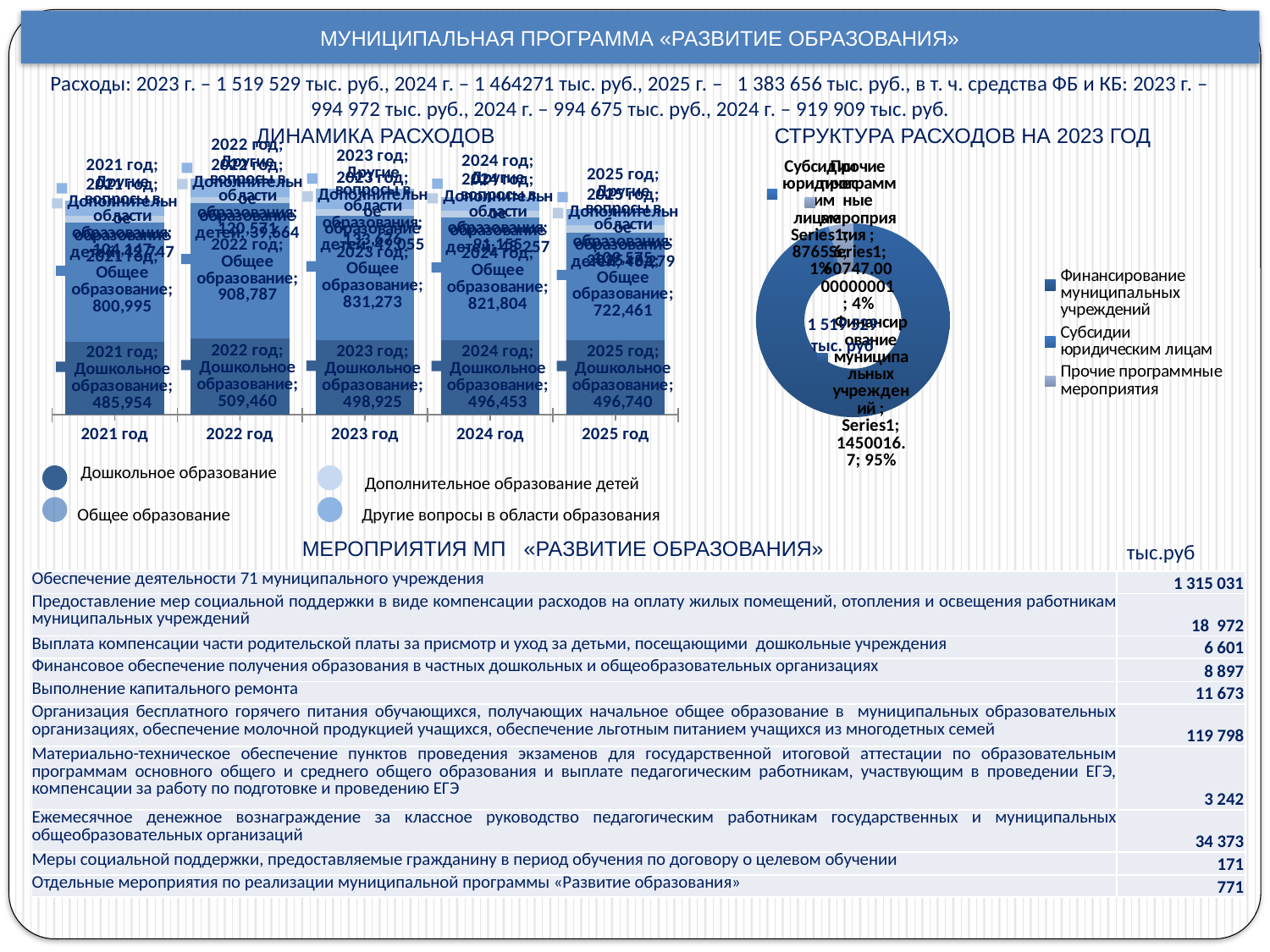
In the ДИНАМИКА РАСХОДОВ chart, what is the value for Общее образование in 2025? 722,461 In the ДИНАМИКА РАСХОДОВ chart, what is the value for Дошкольное образование in 2024? 496,453 In the ДИНАМИКА РАСХОДОВ chart, which year has the highest value for Общее образование? 2022 год In the ДИНАМИКА РАСХОДОВ chart, what is the value for Дошкольное образование in 2022? 509,460 In the СТРУКТУРА РАСХОДОВ НА 2023 ГОД chart, what share does Финансирование муниципальных учреждений have? 95% How many entries does the legend of the СТРУКТУРА РАСХОДОВ НА 2023 ГОД chart list? 3 In the ДИНАМИКА РАСХОДОВ chart, which year has the lowest value for Дошкольное образование? 2021 год In the ДИНАМИКА РАСХОДОВ chart, which is larger: Дошкольное образование in 2023 or in 2025? 2023 (498,925) In the ДИНАМИКА РАСХОДОВ chart, what is the value for Общее образование in 2023? 831,273 In the ДИНАМИКА РАСХОДОВ chart, what is the difference between Общее образование in 2022 and in 2023? 77,514 How many years are shown on the x axis of the ДИНАМИКА РАСХОДОВ chart? 5 What type of chart is ДИНАМИКА РАСХОДОВ? Stacked bar chart